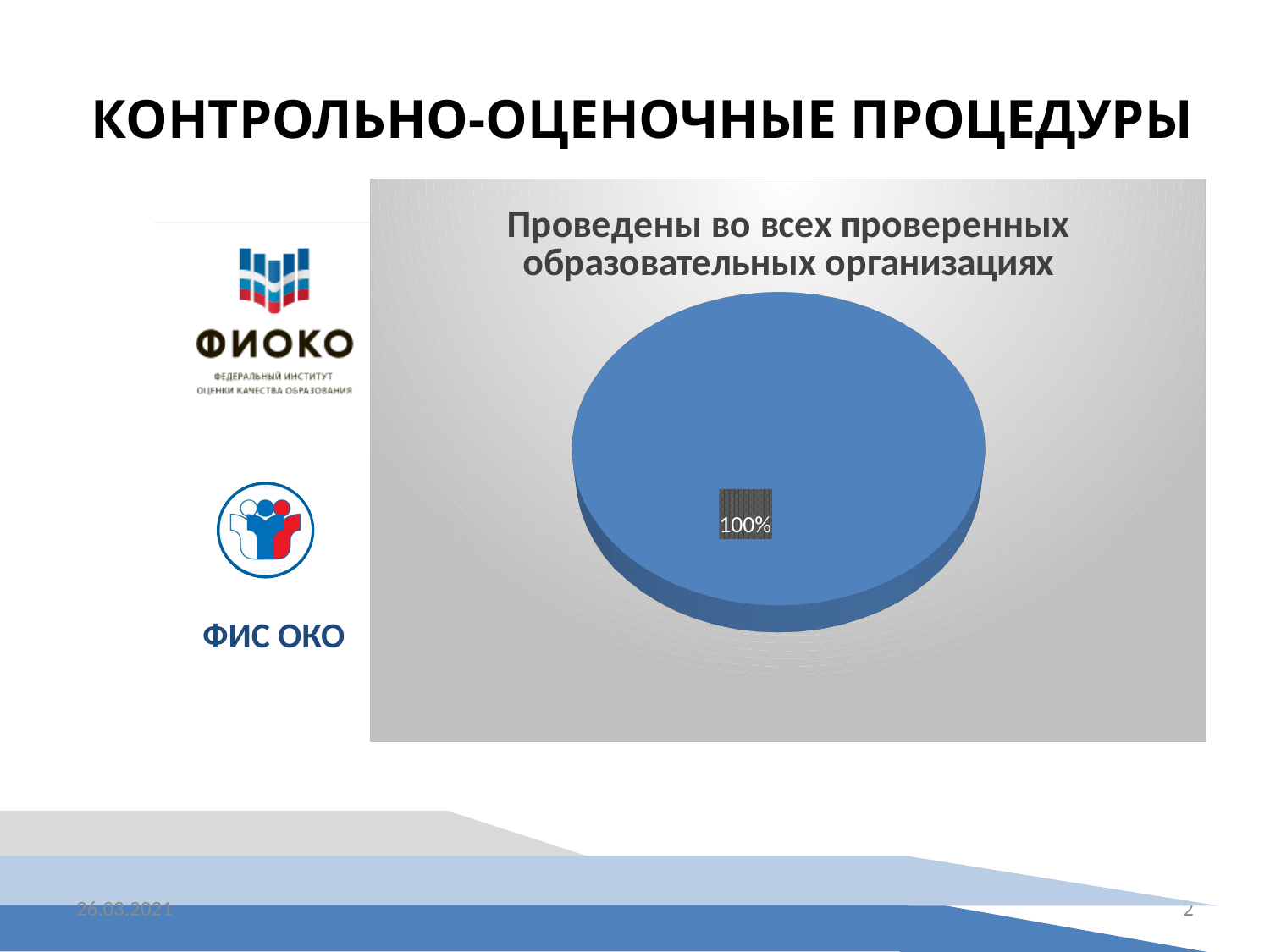
How many slices does the pie chart have? 1 What kind of chart is shown on the slide? pie chart Is the value shown on the pie chart greater or less than 50%? greater What colour is the pie chart's slice? blue What percentage is printed on the pie chart's slice? 100% What share of the pie does the single slice take up? 100% What is the chart's title? Проведены во всех проверенных образовательных организациях